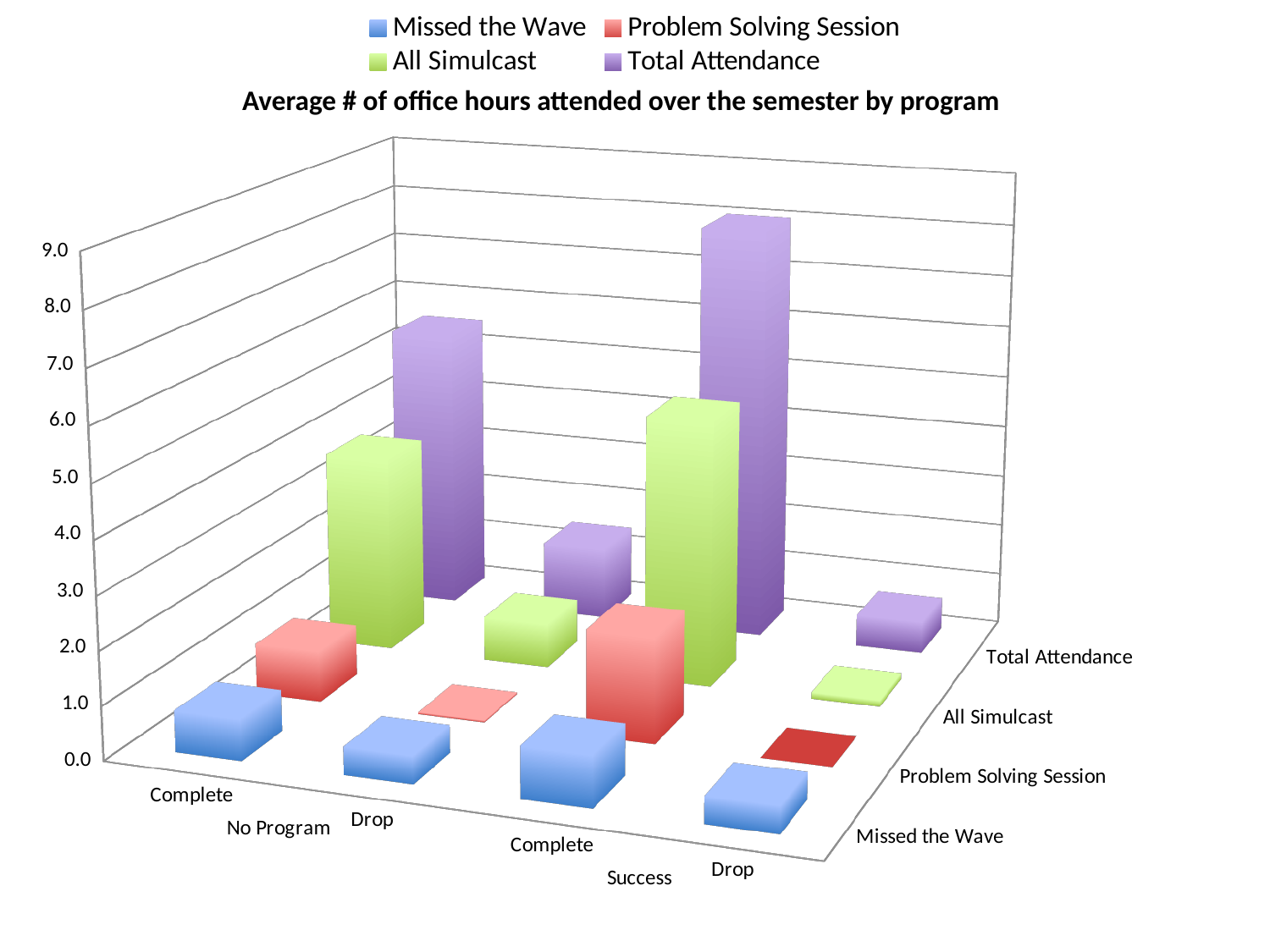
Which is larger, the All Simulcast value for Success Complete or for Success Drop? Success Complete Which category has the highest Total Attendance value? Success Complete Which series is shown in purple in the legend? Total Attendance Is the All Simulcast value for No Program Complete greater or less than 3.0? greater Is the Total Attendance value for Success Complete greater or less than 5.0? greater What kind of chart is shown on the slide? bar chart Is the Total Attendance value for Success Drop greater or less than 2.0? less Which series has the highest value for the Success Complete category? Total Attendance How many series does the legend list? 4 What is the title of the chart? Average # of office hours attended over the semester by program Which is larger, the Total Attendance value for Success Complete or for No Program Complete? Success Complete